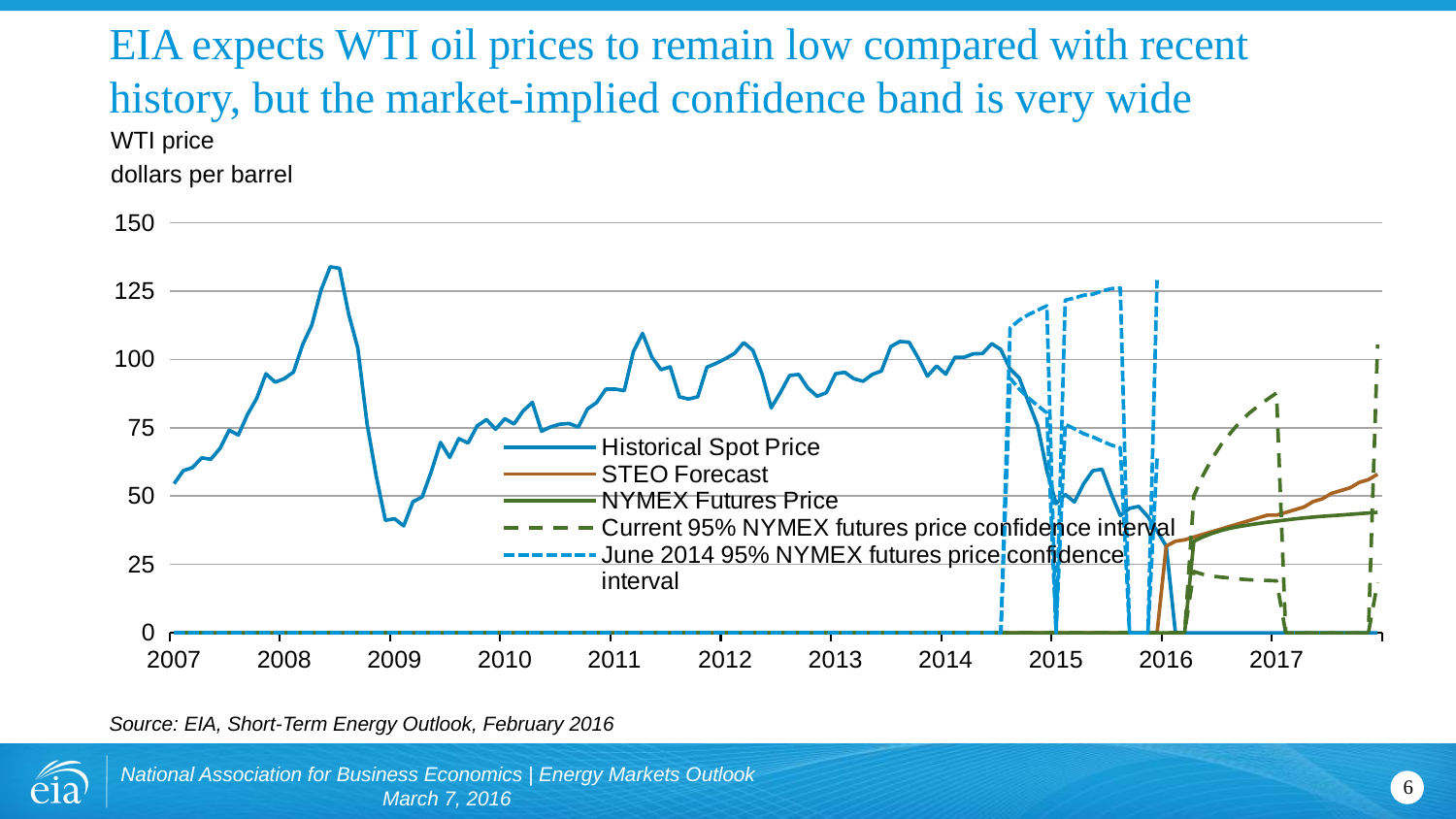
How many series does the legend list? 5 What kind of chart is shown on the slide? line chart How many year labels are shown on the x axis? 11 In which year does the Historical Spot Price reach its highest point? 2008 Is the peak value of the Historical Spot Price in 2008 greater or less than 125? greater Does the STEO Forecast rise or fall from 2016 to the end of 2017? rise Is the Historical Spot Price at the start of 2007 greater or less than 75? less Is the STEO Forecast value at the end of 2017 greater or less than 75? less At the end of 2017, which is higher: the STEO Forecast or the NYMEX Futures Price? STEO Forecast Does the Historical Spot Price rise or fall from mid-2014 to early 2016? fall What unit is the WTI price measured in on the chart? dollars per barrel